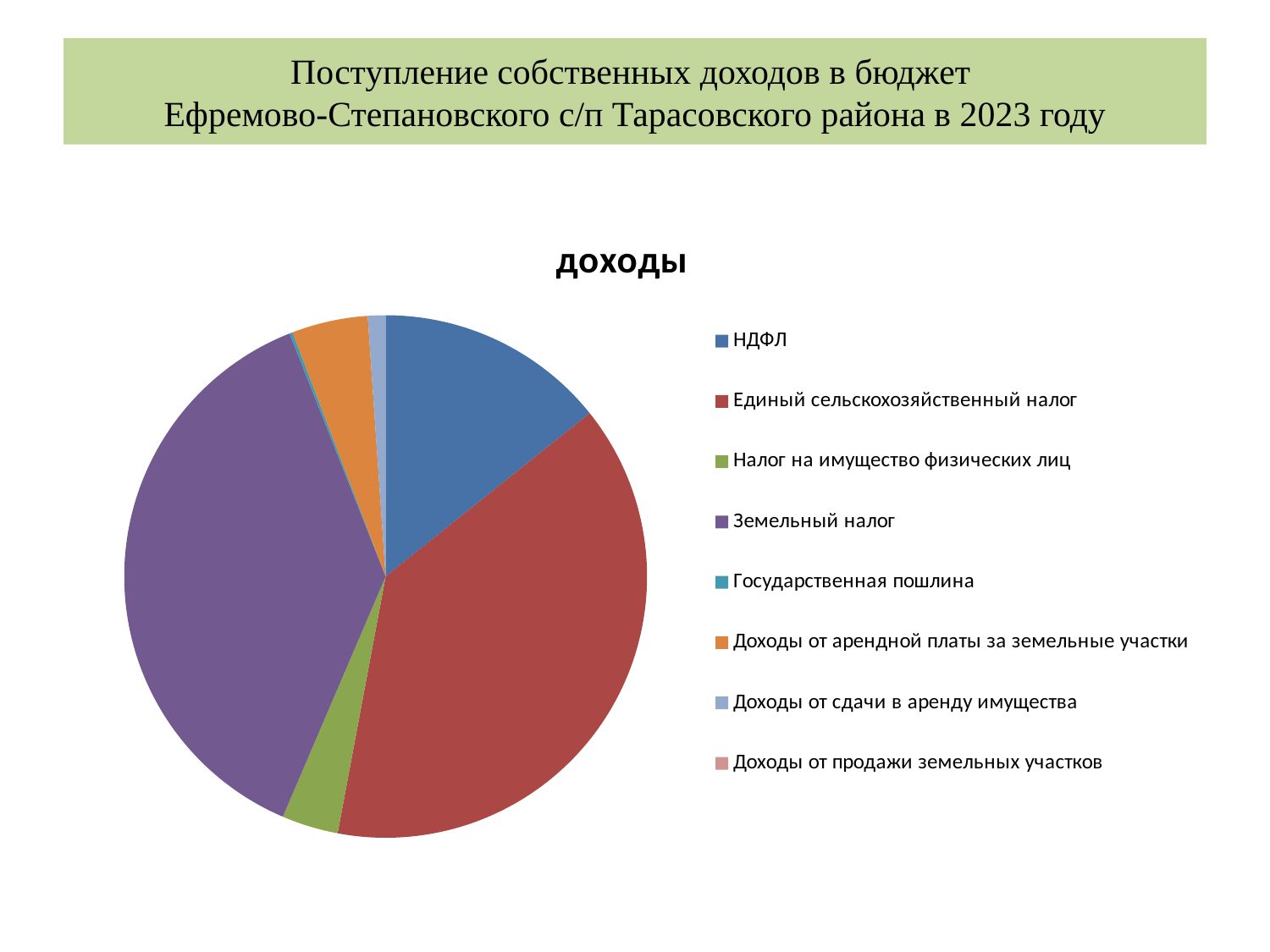
Which slice is larger: Доходы от арендной платы за земельные участки or Доходы от сдачи в аренду имущества? Доходы от арендной платы за земельные участки Which slice is larger: Земельный налог or НДФЛ? Земельный налог Which legend entry is listed first in the pie chart's legend? НДФЛ Which slice is larger: Единый сельскохозяйственный налог or Налог на имущество физических лиц? Единый сельскохозяйственный налог What kind of chart is shown on the slide? pie chart How many categories does the legend of the pie chart list? 8 What is the title of the pie chart? доходы What colour is the НДФЛ slice in the pie chart? blue